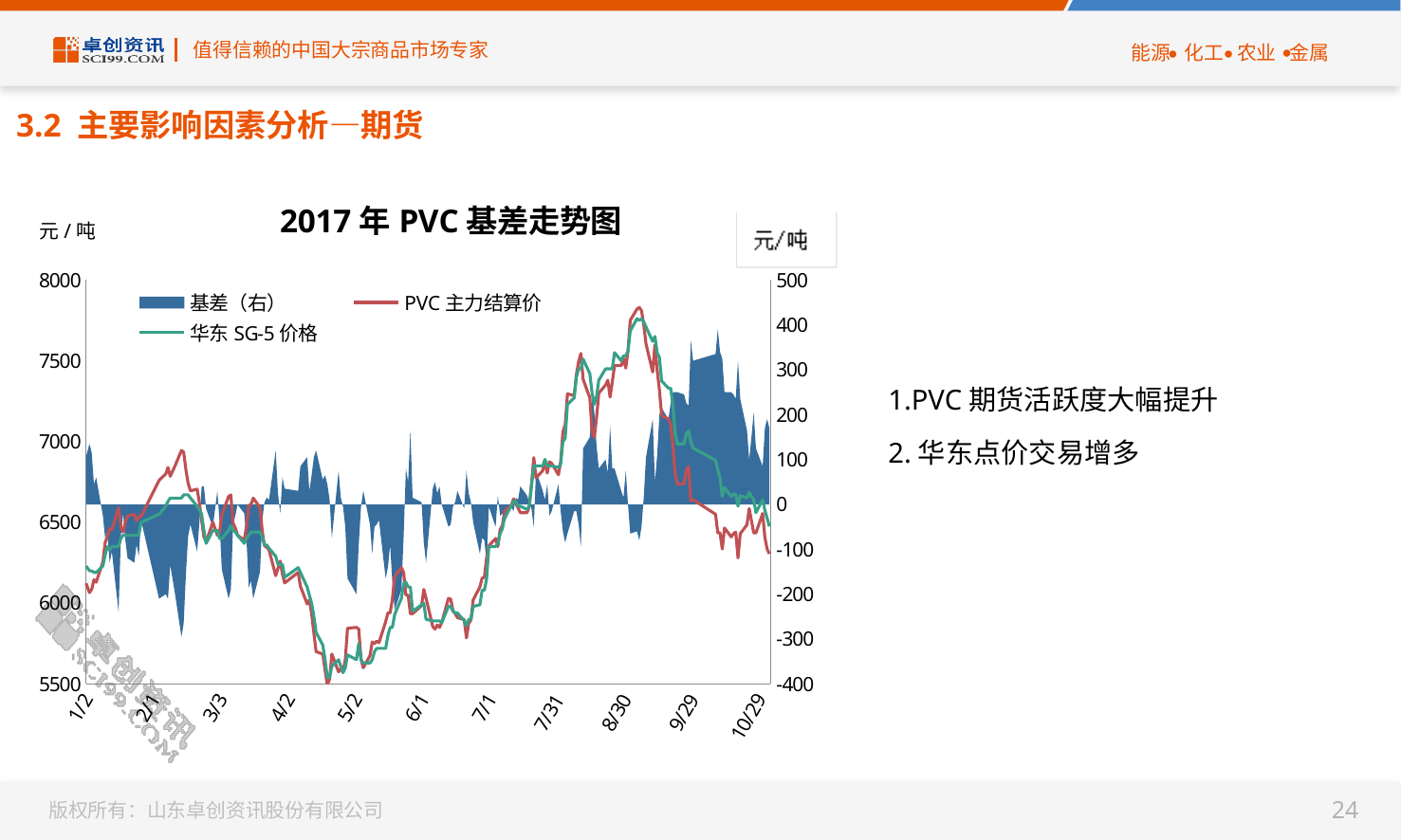
Does the PVC主力结算价 rise or fall between 8/30 and 10/29? fall Is the 基差 around 9/29 greater or less than 200? greater Does the PVC主力结算价 rise or fall between 5/2 and 8/30? rise Which series in the legend is plotted against the right axis? 基差（右） What is the lowest value shown on the right vertical axis? -400 What is the title of the chart? 2017年PVC基差走势图 How many series does the chart legend list? 3 Is the PVC主力结算价 around 5/2 greater or less than 6000? less What is the highest value shown on the left vertical axis? 8000 How many date labels are shown on the x axis? 11 Is the 华东SG-5价格 at 1/2 greater or less than 6500? less